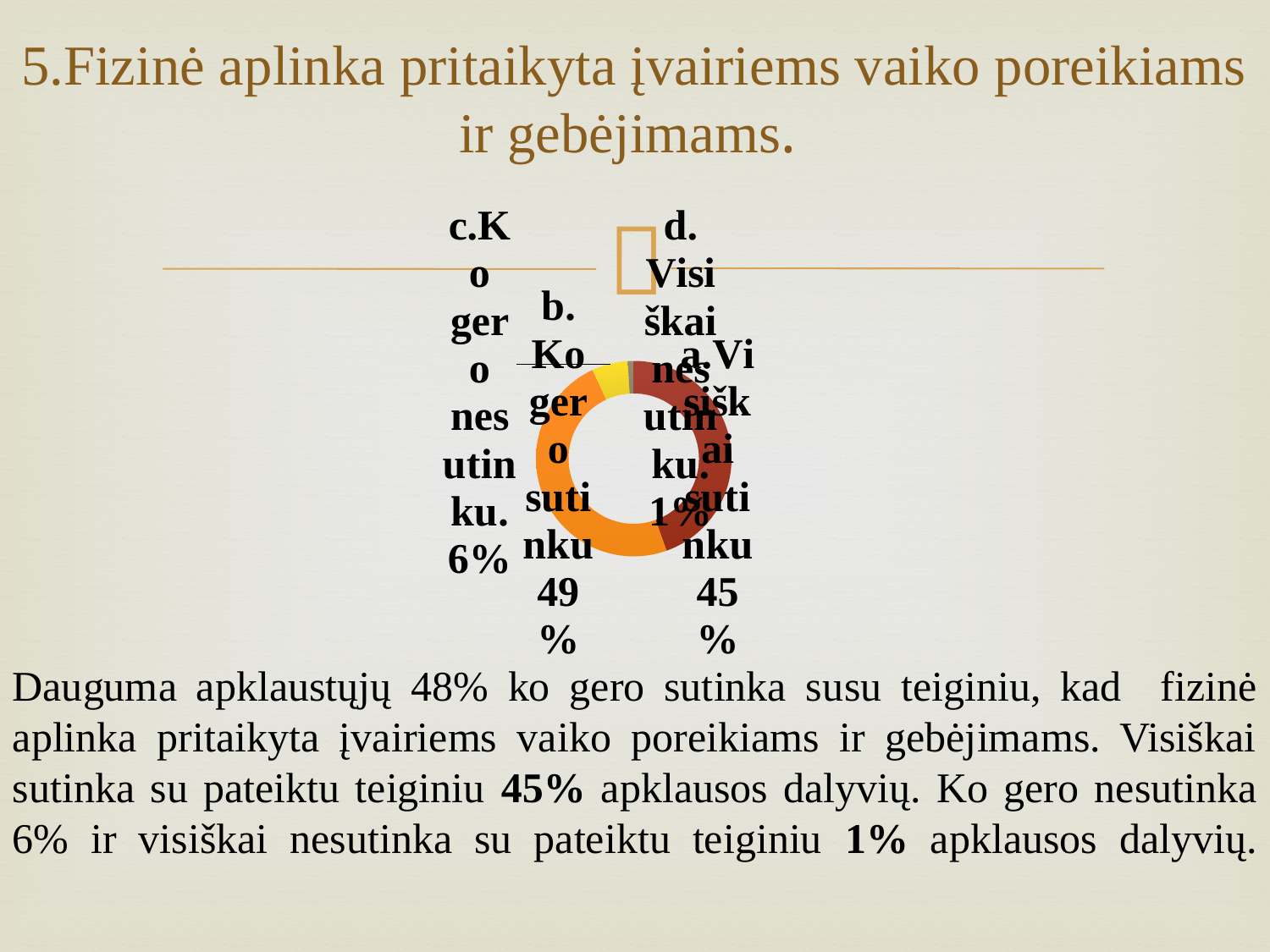
Which is larger: the share for "c. Ko gero nesutinku" or for "d. Visiškai nesutinku"? c. Ko gero nesutinku What colour is the slice for "a. Visiškai sutinku"? dark red What is the combined percentage of "c. Ko gero nesutinku" and "d. Visiškai nesutinku"? 7% How many categories are shown in the doughnut chart? 4 What is the difference in percentage points between "b. Ko gero sutinku" and "a. Visiškai sutinku"? 4 Which category has the largest share of the doughnut chart? b. Ko gero sutinku What percentage is shown for "c. Ko gero nesutinku"? 6% What kind of chart is shown on the slide? doughnut chart What percentage is shown for "a. Visiškai sutinku"? 45% What percentage is shown for "d. Visiškai nesutinku"? 1% Which category has the smallest share of the doughnut chart? d. Visiškai nesutinku What percentage is shown for "b. Ko gero sutinku"? 49%